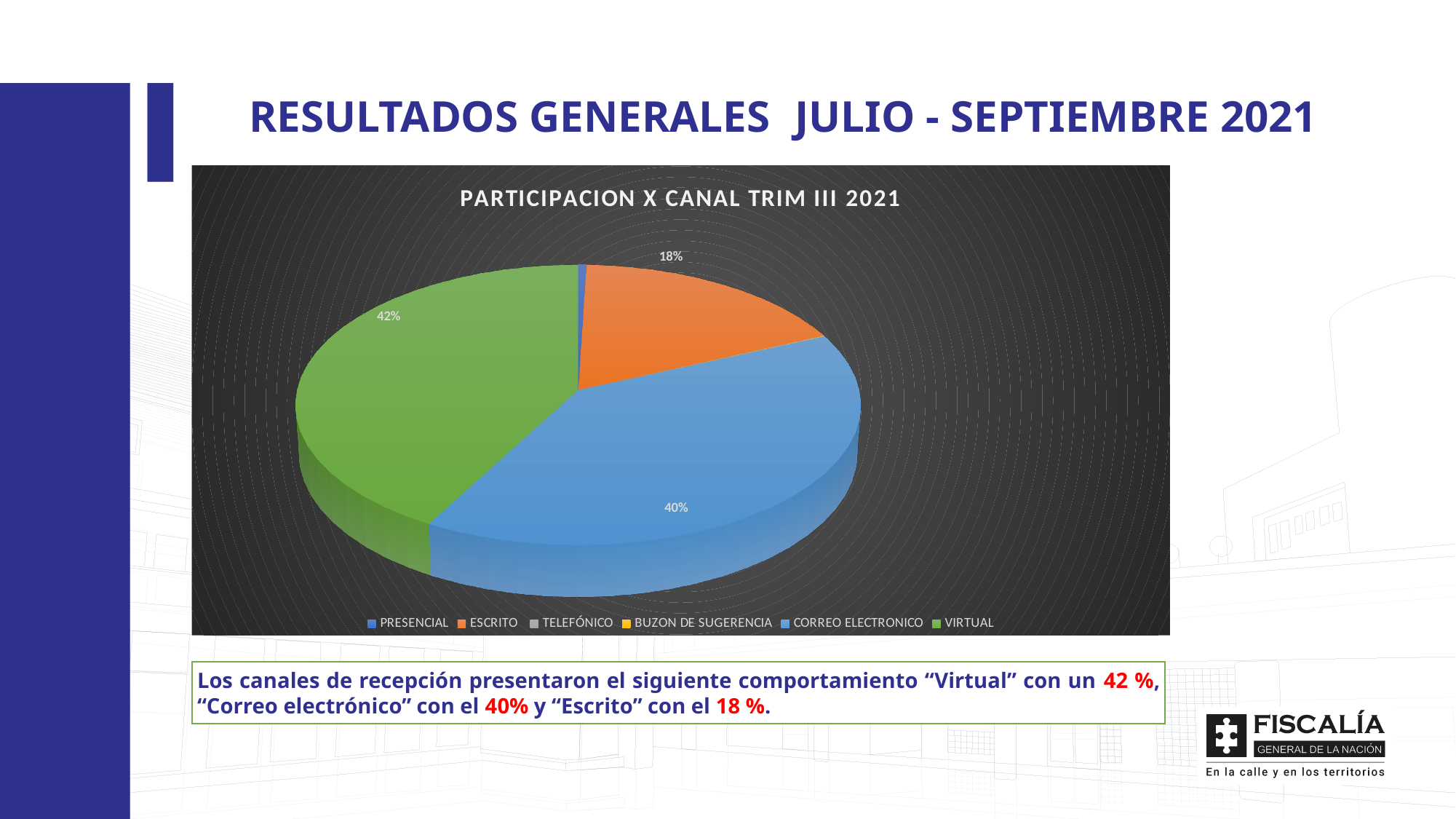
Which is larger, the share for VIRTUAL or the share for CORREO ELECTRONICO? VIRTUAL What share of the pie does the ESCRITO slice take? 18% What type of chart is shown on the slide? Pie chart What is the difference in percentage points between the VIRTUAL and ESCRITO slices? 24 What percentage does the CORREO ELECTRONICO slice represent? 40% What percentage does the VIRTUAL slice represent in the pie chart? 42% How many entries does the chart legend list? 6 Which is larger, the share for ESCRITO or the share for CORREO ELECTRONICO? CORREO ELECTRONICO Which channel has the largest share in the pie chart? VIRTUAL What is the difference in percentage points between the CORREO ELECTRONICO and ESCRITO slices? 22 What percentage does the ESCRITO slice represent? 18% What is the title of the chart? PARTICIPACION X CANAL TRIM III 2021